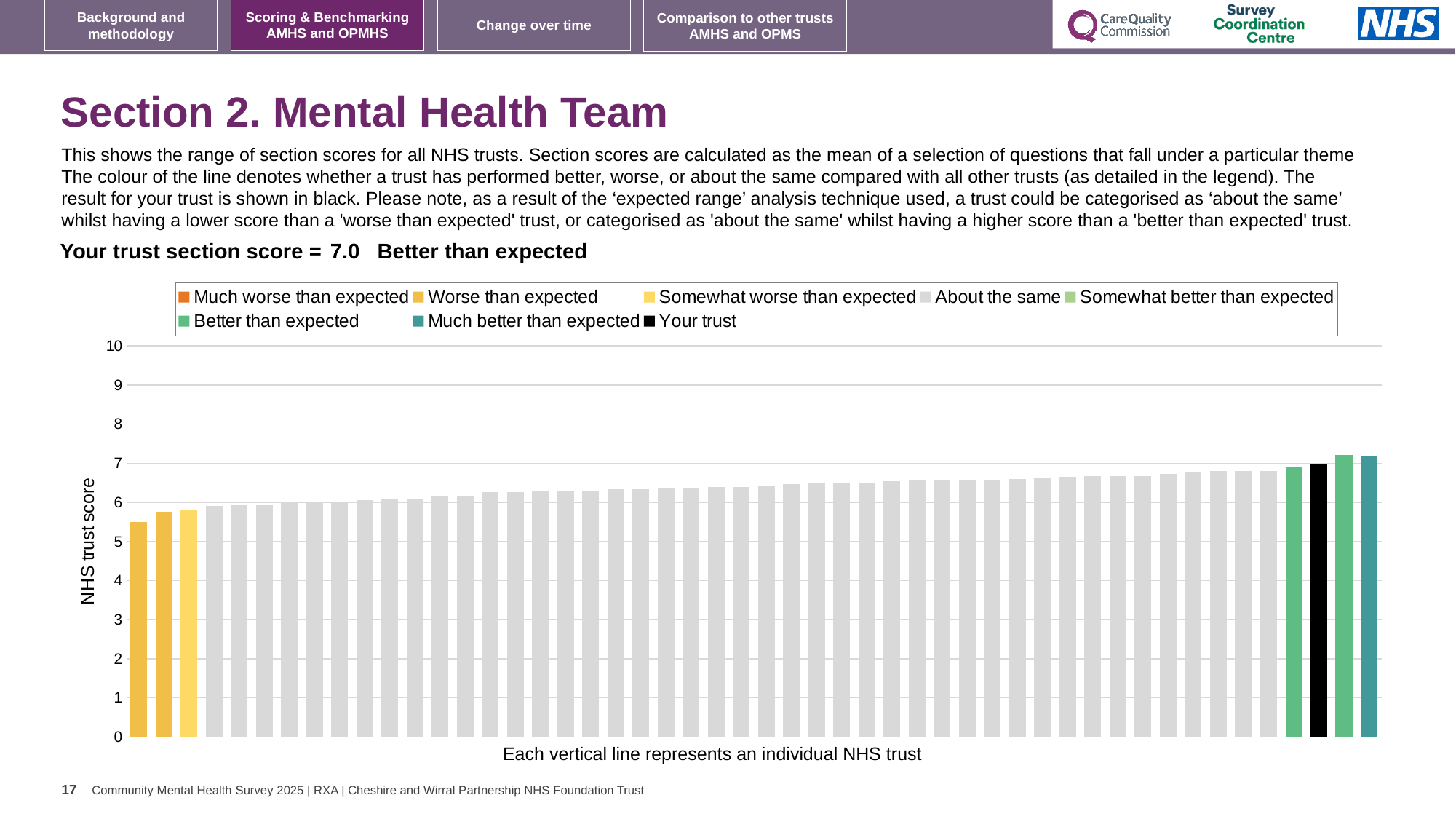
Do the bar values rise or fall from left to right across the chart? rise Is the value of the black bar (your trust) greater or less than 6? greater Which performance category is your trust placed in for this section? Better than expected How many bars are coloured yellow (worse or somewhat worse than expected)? 3 What kind of chart is shown on the slide? bar chart Is the black bar (your trust) higher or lower than the leftmost bar? higher Is the value of the highest bar greater or less than 8? less Is the value of the leftmost (lowest) bar greater or less than 6? less How many entries does the chart legend list? 8 How many bars are coloured in the teal 'Much better than expected' colour? 1 What is the section score for your trust shown on the slide? 7.0 What is the label on the vertical axis of the chart? NHS trust score